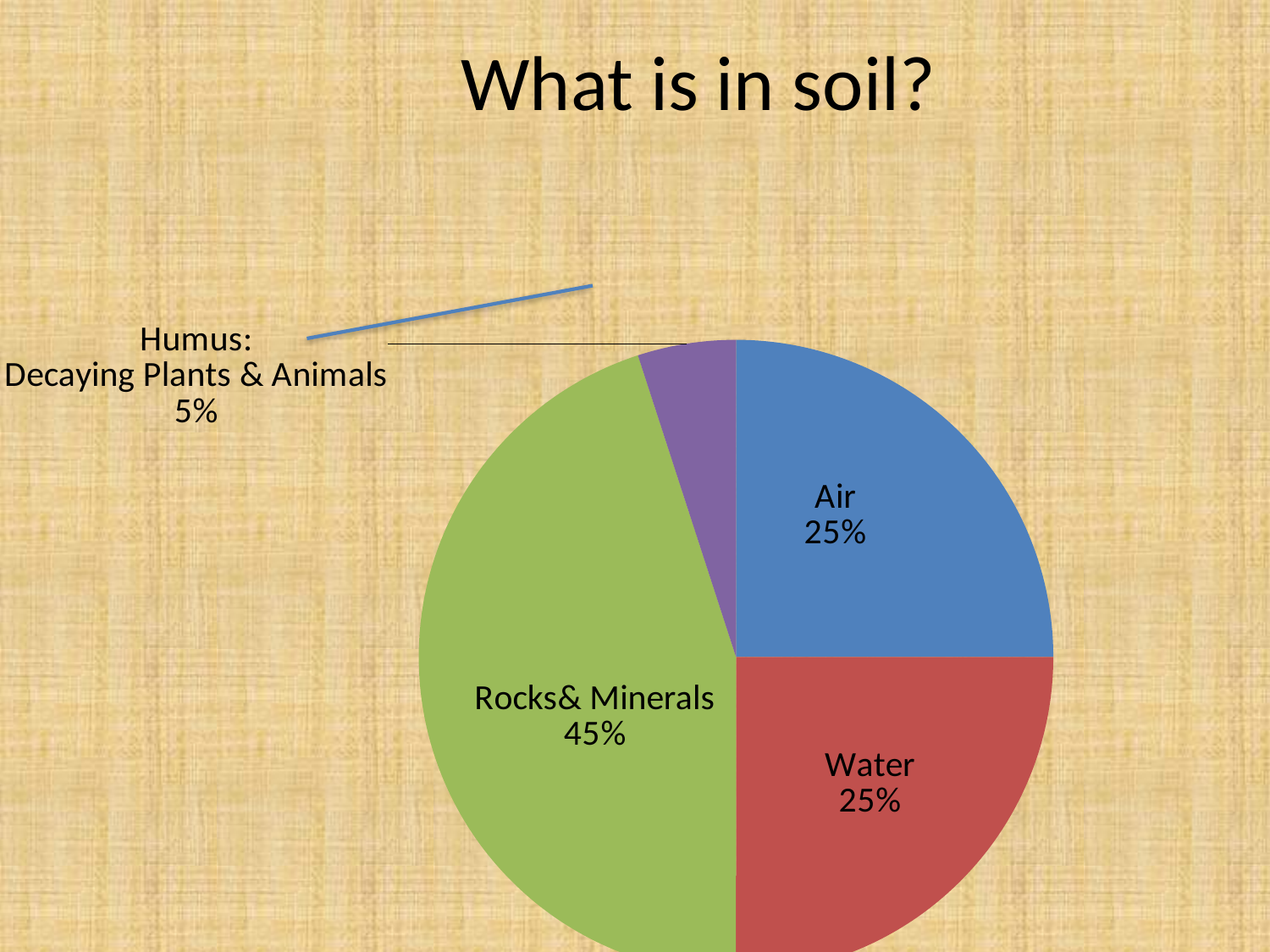
Which component makes up the largest share of soil in the chart? Rocks & Minerals What is the difference between the Rocks & Minerals share and the Air share? 20% What percentage of soil is Rocks & Minerals according to the chart? 45% What is the title of the slide containing the pie chart? What is in soil? Which component makes up the smallest share of soil in the chart? Humus What percentage of soil is Water according to the chart? 25% How many slices does the pie chart have? 4 What is the difference between the Water share and the Humus share? 20% What percentage of soil is Humus (Decaying Plants & Animals) according to the chart? 5% What kind of chart is shown on the slide? pie chart Which is larger, the share for Rocks & Minerals or the share for Water? Rocks & Minerals What percentage of soil is Air according to the chart? 25%